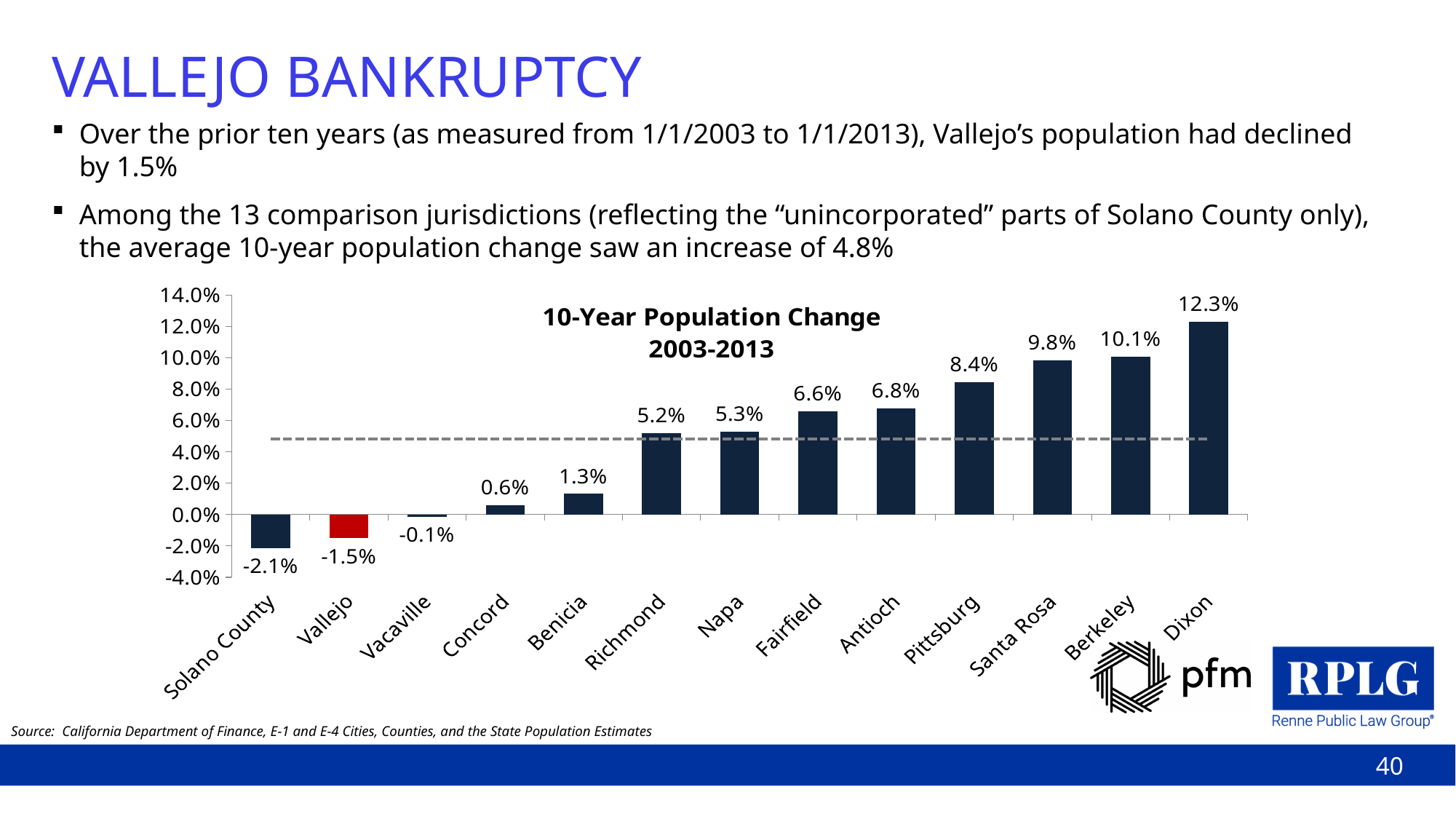
What is the 10-year population change shown for Vallejo? -1.5% What is the difference between the population change for Dixon and for Berkeley? 2.2% Do the values generally rise or fall moving from left to right along the x axis? Rise Which jurisdiction has the highest 10-year population change in the chart? Dixon What is the 10-year population change shown for Dixon? 12.3% What is the 10-year population change shown for Fairfield? 6.6% What kind of chart is used to show the 10-year population change? Bar chart How many jurisdictions are shown on the x axis of the chart? 13 Is the value for Santa Rosa greater or less than 8.0%? greater Which has a larger 10-year population change, Pittsburg or Antioch? Pittsburg Which jurisdiction has the lowest 10-year population change in the chart? Solano County Which jurisdiction's bar is coloured red in the chart? Vallejo